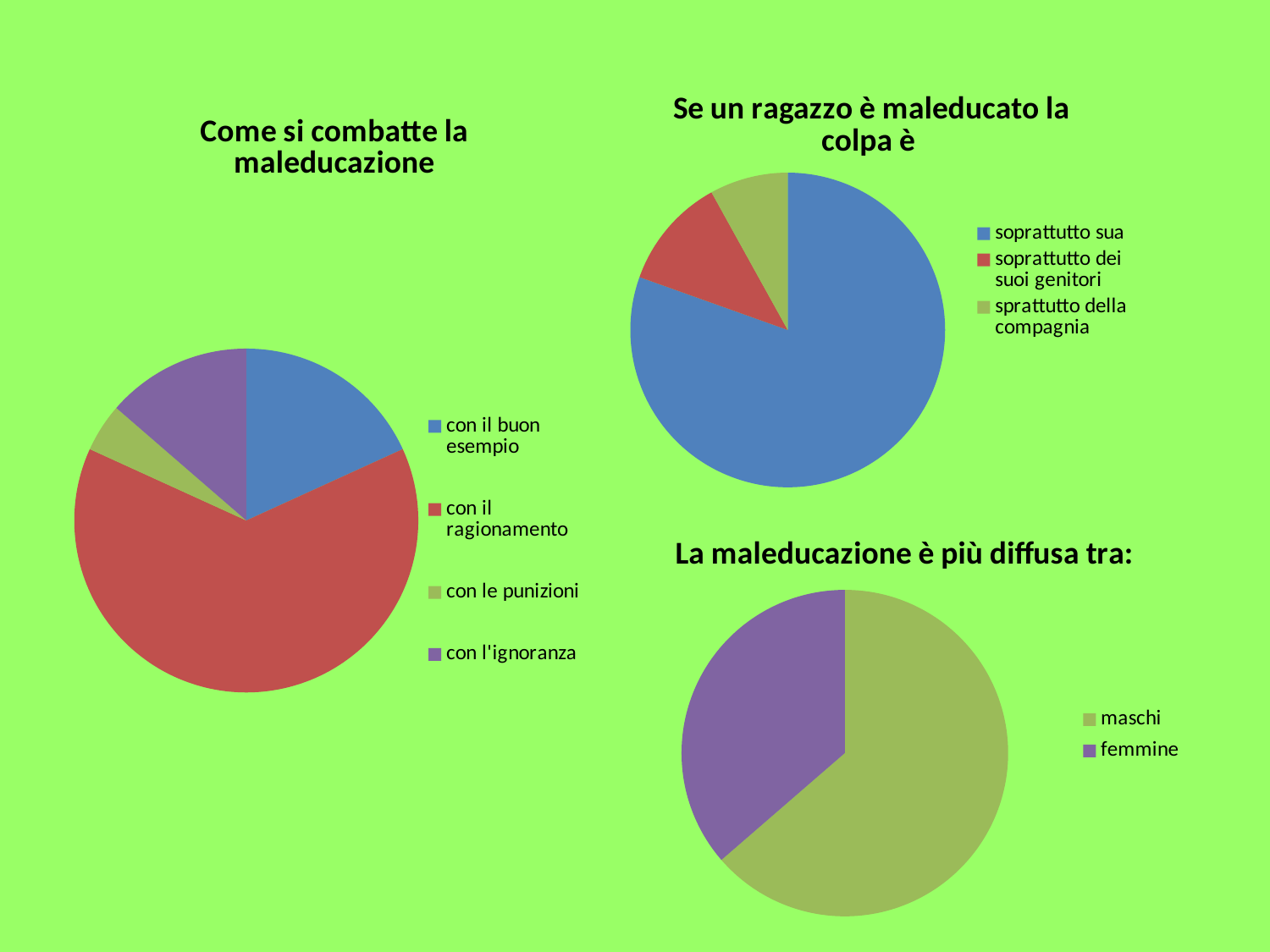
In the "Come si combatte la maleducazione" chart, which slice is larger: con il ragionamento or con il buon esempio? con il ragionamento How many entries does the legend of the "Se un ragazzo è maleducato la colpa è" chart list? 3 In the "La maleducazione è più diffusa tra:" chart, what colour is the femmine slice? purple In the "Come si combatte la maleducazione" chart, which category has the smallest slice? con le punizioni In the "La maleducazione è più diffusa tra:" chart, which category has the larger slice? maschi What kind of chart is "Come si combatte la maleducazione"? pie chart How many pie charts are shown on the slide? 3 In the "Se un ragazzo è maleducato la colpa è" chart, which slice is larger: soprattutto sua or soprattutto dei suoi genitori? soprattutto sua How many slices does the "Come si combatte la maleducazione" pie chart have? 4 How many slices does the "La maleducazione è più diffusa tra:" pie chart have? 2 In the "Se un ragazzo è maleducato la colpa è" chart, which category has the largest slice? soprattutto sua In the "Come si combatte la maleducazione" chart, which category has the largest slice? con il ragionamento